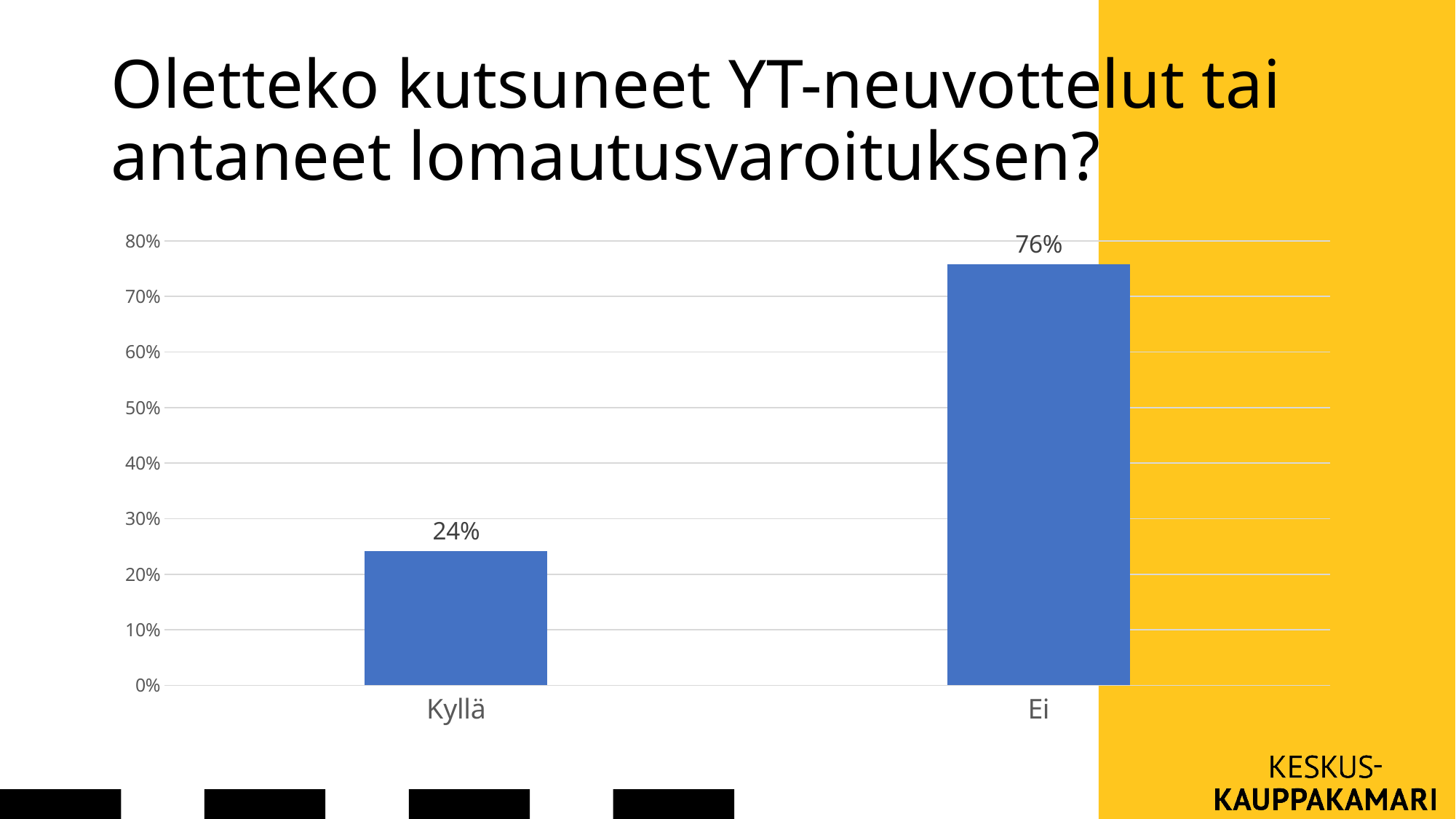
Which category has the lowest value? Kyllä What is the difference between the values for Ei and Kyllä? 52% Is the value for Ei greater or less than 70%? greater What is the value for Kyllä? 24% Is the value for Kyllä greater or less than 30%? less How many categories are shown in the chart? 2 What kind of chart is shown on the slide? bar chart What is the title of the slide? Oletteko kutsuneet YT-neuvottelut tai antaneet lomautusvaroituksen? What is the total of the two values shown in the chart? 100% Which is larger, the value for Kyllä or the value for Ei? Ei What is the value for Ei? 76% Which category has the highest value? Ei